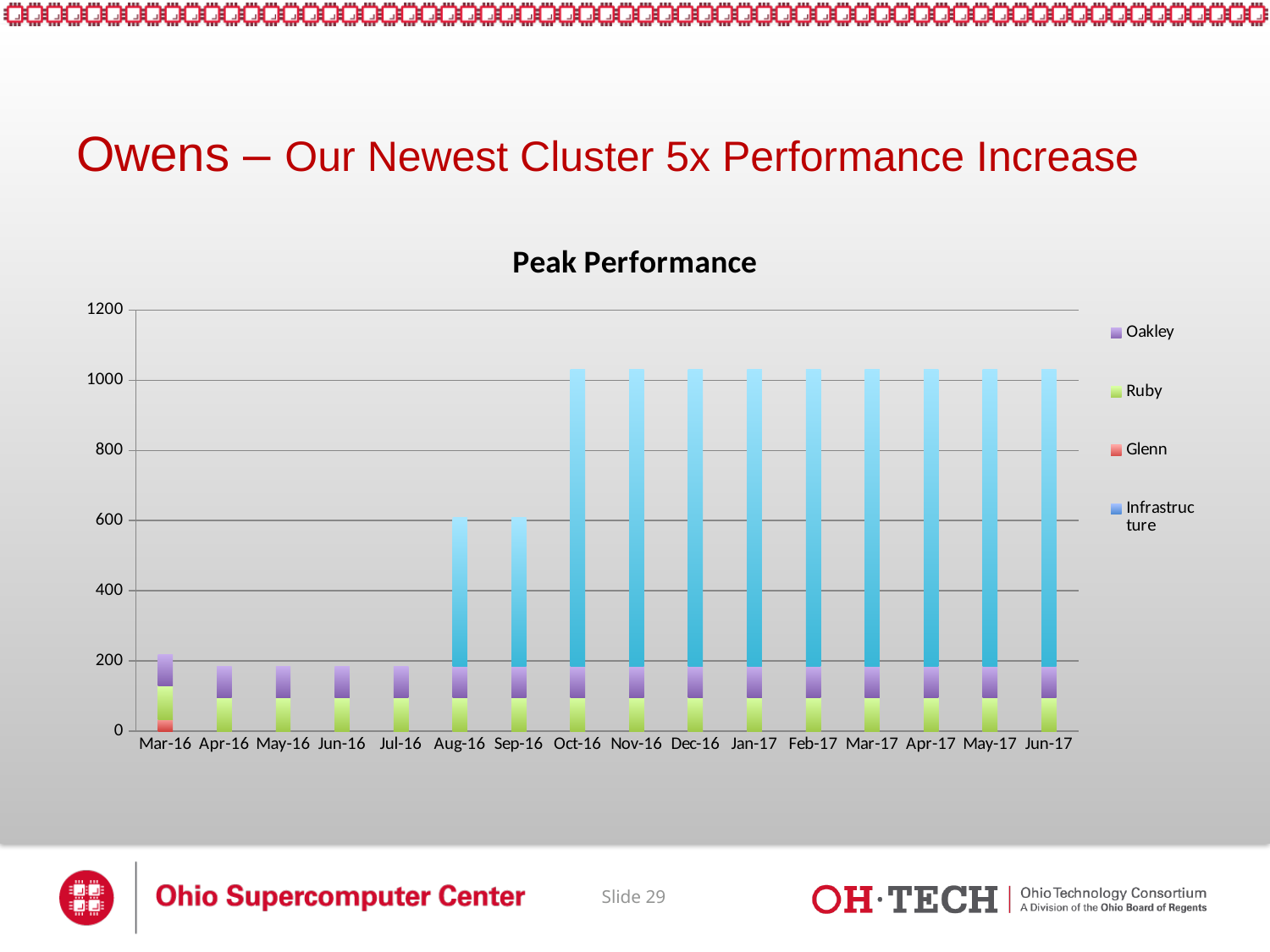
Do the total values generally rise or fall from Mar-16 to Jun-17? rise How many series does the legend list? 4 What is the title of the chart? Peak Performance Which has the larger total, Aug-16 or Oct-16? Oct-16 Is the total value for Aug-16 greater or less than 400? greater How many months are shown along the x axis? 16 Which series is listed first in the legend? Oakley Which has the larger total, Jul-16 or Aug-16? Aug-16 What type of chart is shown on the slide? stacked bar chart Is the total value for Oct-16 greater or less than 800? greater Is the total value for Apr-16 greater or less than 200? less